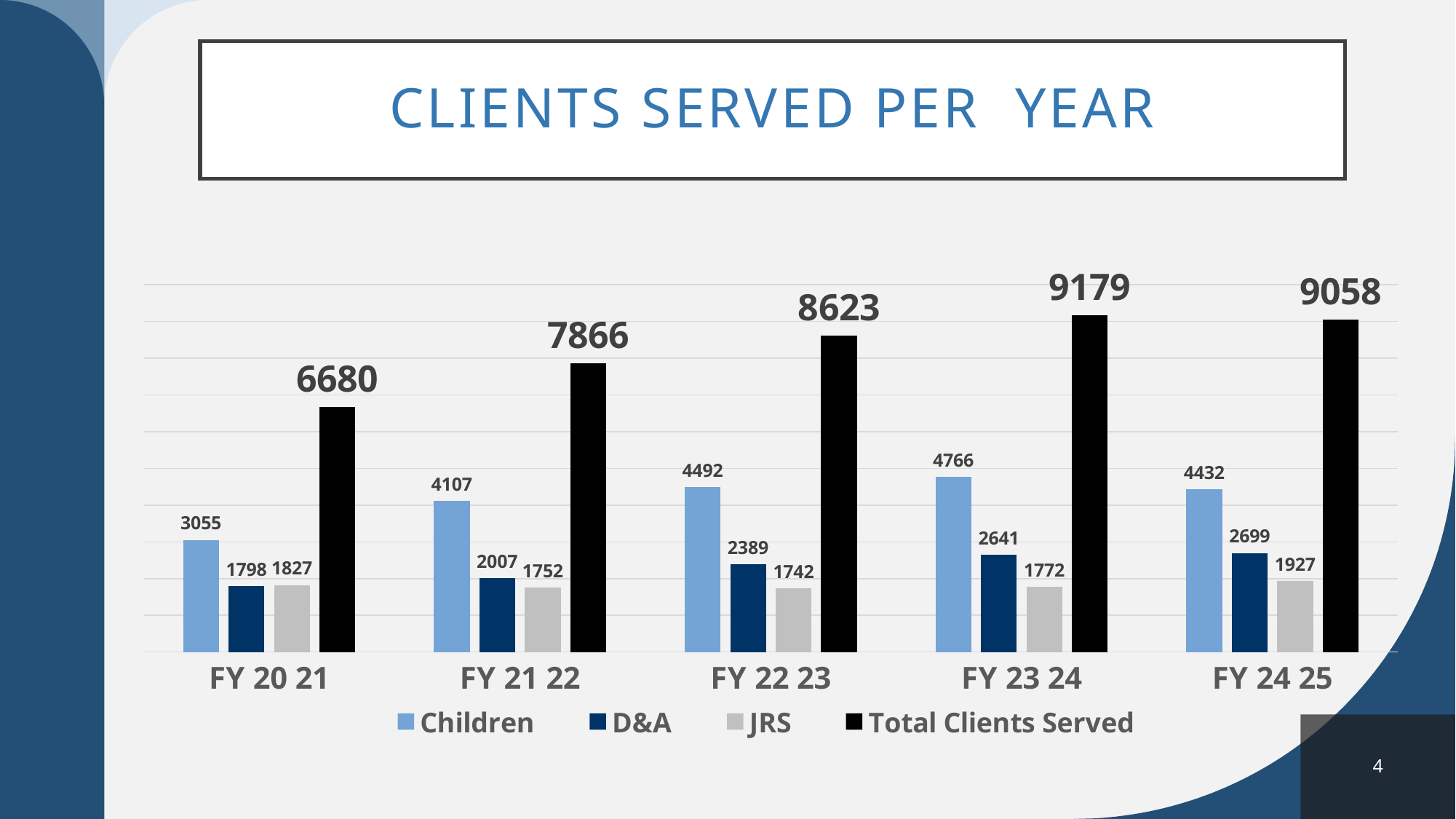
How many series does the legend list? 4 Which fiscal year has the highest Total Clients Served? FY 23 24 What is the title of the chart? CLIENTS SERVED PER YEAR What is the Total Clients Served value for FY 20 21? 6680 What is the value for Children in FY 22 23? 4492 What is the value for JRS in FY 24 25? 1927 Which fiscal year has the lowest value for Children? FY 20 21 How many fiscal years are shown on the x axis? 5 What is the value for D&A in FY 21 22? 2007 Which is larger, D&A in FY 23 24 or D&A in FY 24 25? D&A in FY 24 25 What kind of chart is shown on the slide? Bar chart What is the difference between Total Clients Served in FY 23 24 and FY 24 25? 121